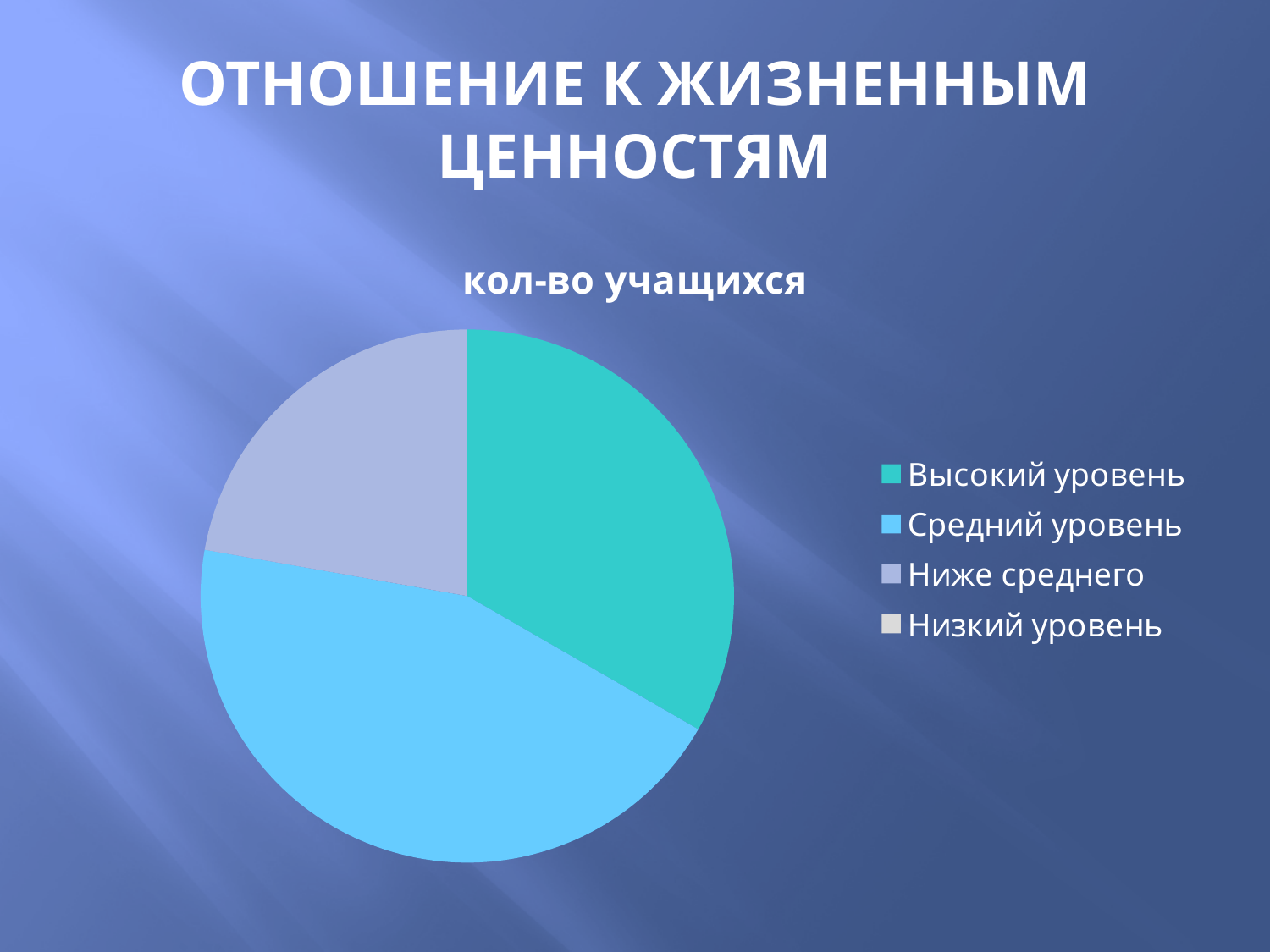
Which colour represents Высокий уровень in the chart? teal (green-blue) What is the title of the chart? кол-во учащихся Of the slices visible in the pie, which category has the smallest one? Ниже среднего What kind of chart is shown on the slide? pie chart How many entries does the chart legend list? 4 Which slice is larger, Средний уровень or Высокий уровень? Средний уровень Which category has the largest slice of the pie? Средний уровень Which slice is larger, Высокий уровень or Ниже среднего? Высокий уровень